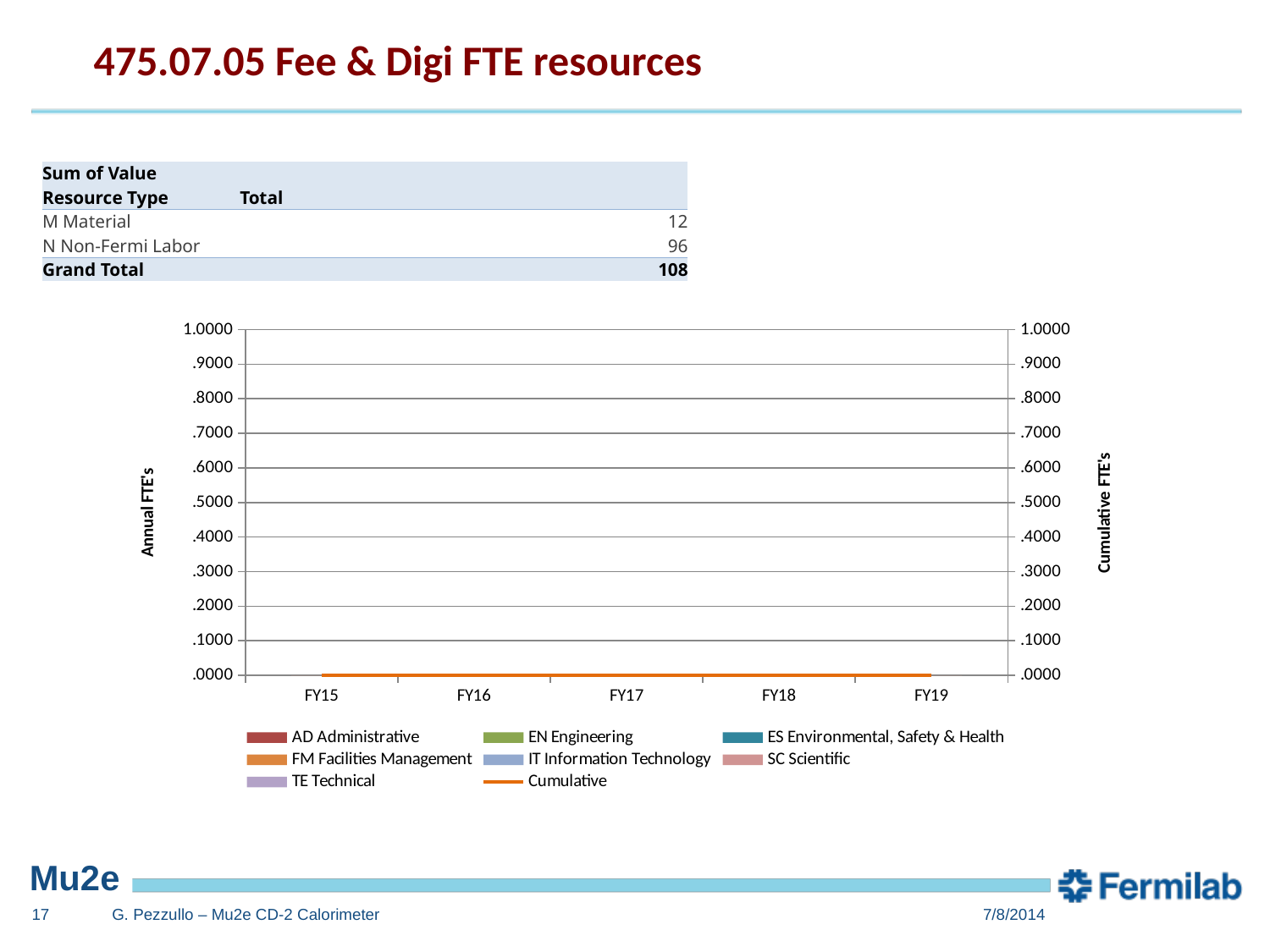
What is the first fiscal year label on the x axis of the chart? FY15 What is the title of the left vertical axis of the chart? Annual FTE's What is the value of the Cumulative line at FY19? .0000 Is the value of the Cumulative line at FY17 greater or less than .5000? less What is the value of the Cumulative line at FY15? .0000 Does the Cumulative line rise, fall, or stay flat from FY15 to FY19? Stays flat How many series does the chart's legend list? 8 How many fiscal years are shown on the x axis of the chart? 5 What is the highest tick value shown on the left vertical axis of the chart? 1.0000 What is the title of the right vertical axis of the chart? Cumulative FTE's What kind of chart is shown on the slide? Bar chart with a line series